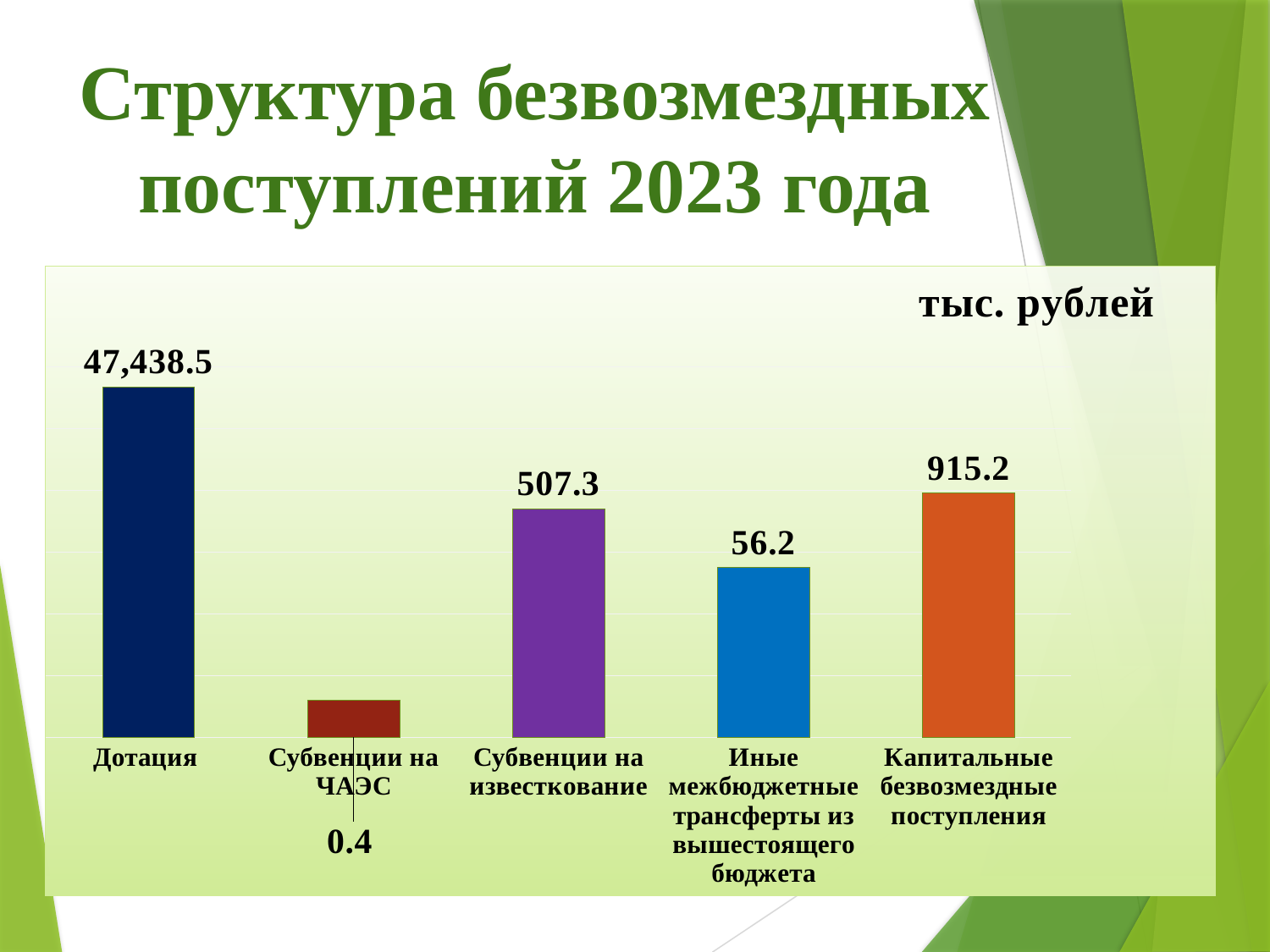
What is the value for Субвенции на ЧАЭС? 0.4 What is the difference between Субвенции на известкование and Иные межбюджетные трансферты из вышестоящего бюджета? 451.1 What is the difference between Капитальные безвозмездные поступления and Субвенции на известкование? 407.9 Which is larger, Капитальные безвозмездные поступления or Субвенции на известкование? Капитальные безвозмездные поступления What is the value for Субвенции на известкование? 507.3 What is the value for Дотация? 47,438.5 Which category has the lowest value? Субвенции на ЧАЭС What is the value for Иные межбюджетные трансферты из вышестоящего бюджета? 56.2 How many categories are shown in the chart? 5 What is the value for Капитальные безвозмездные поступления? 915.2 Which category has the highest value? Дотация What kind of chart is shown on the slide? Bar chart